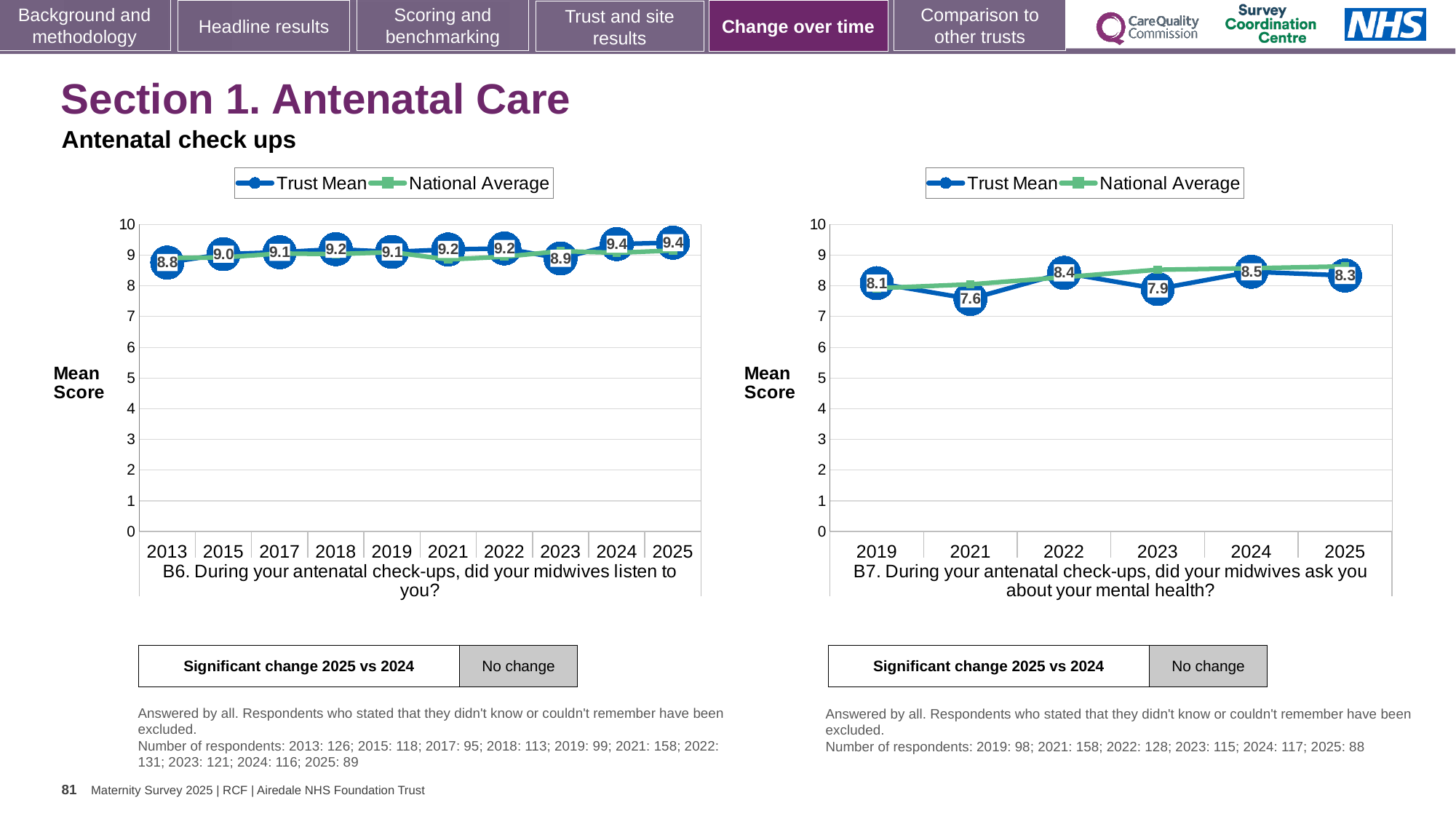
In the B7 chart (right), what is the difference between the Trust Mean for 2024 and for 2021? 0.9 In the B6 chart (left), is the Trust Mean higher in 2023 or in 2024? 2024 In the B7 chart (right), what is the Trust Mean for 2021? 7.6 In the B6 chart (left), what is the difference between the Trust Mean for 2025 and for 2013? 0.6 In the B6 chart (left), what is the Trust Mean for 2013? 8.8 In the B6 chart (left), which year has the lowest Trust Mean? 2013 In the B7 chart (right), which year has the lowest Trust Mean? 2021 In the B6 chart (left), how many years are plotted on the x axis? 10 How many series does the legend of the B7 chart (right) list? 2 In the B7 chart (right), is the National Average for 2025 greater or less than 8? greater In the B6 chart (left), what is the Trust Mean for 2025? 9.4 In the B7 chart (right), which year has the highest Trust Mean? 2024